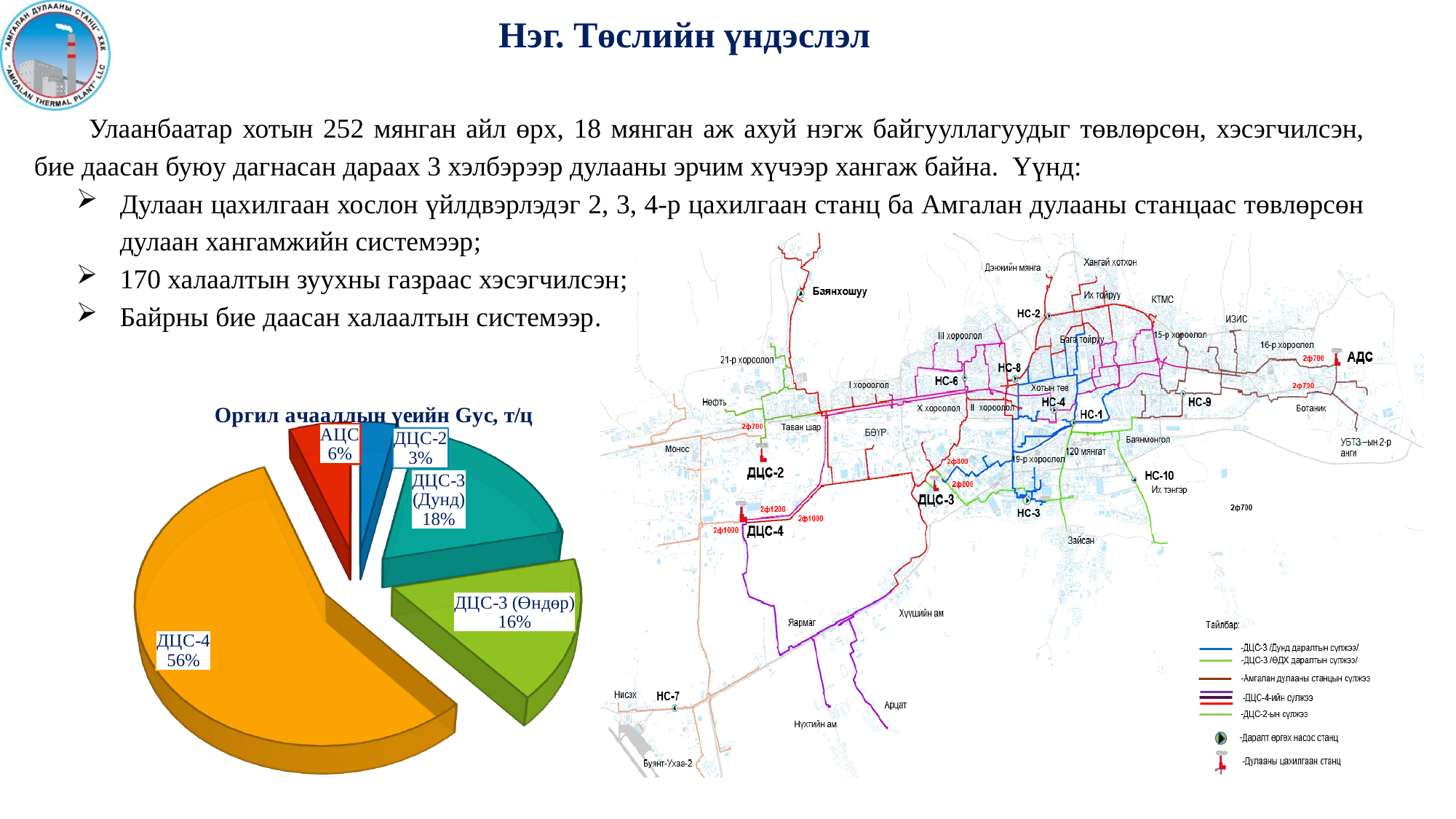
What share of the pie does АЦС have? 6% Which slice of the pie chart is the largest? ДЦС-4 What share of the pie does ДЦС-3 (Дунд) have? 18% What is the title of the pie chart? Оргил ачааллын үеийн Gус, т/ц What share of the pie does ДЦС-4 have? 56% What share of the pie does ДЦС-2 have? 3% How many slices does the pie chart have? 5 What is the difference in percentage points between ДЦС-3 (Дунд) and ДЦС-3 (Өндөр)? 2% Which is larger, the share for АЦС or the share for ДЦС-2? АЦС Which slice of the pie chart is the smallest? ДЦС-2 What share of the pie does ДЦС-3 (Өндөр) have? 16% What kind of chart is shown on the slide? pie chart